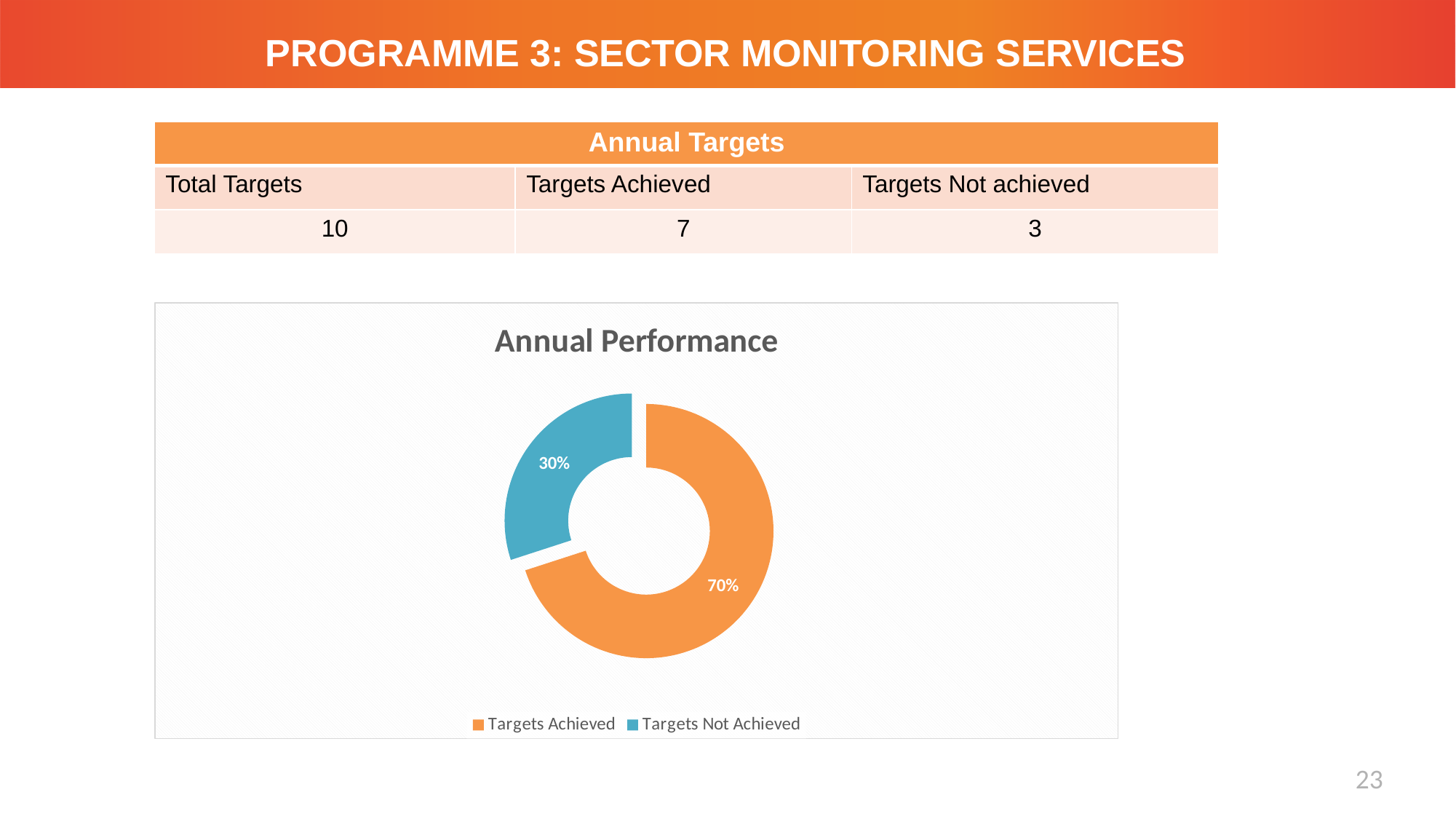
Which slice of the chart is the smallest? Targets Not Achieved What kind of chart is shown on the slide? doughnut chart What share of the chart does Targets Achieved represent? 70% What colour is the Targets Not Achieved slice? blue Which slice of the chart is the largest? Targets Achieved What is the title of the chart? Annual Performance How many entries does the chart legend list? 2 How many slices does the chart have? 2 What share of the chart does Targets Not Achieved represent? 30% Which is larger, Targets Achieved or Targets Not Achieved? Targets Achieved What is the difference in percentage points between Targets Achieved and Targets Not Achieved? 40 percentage points